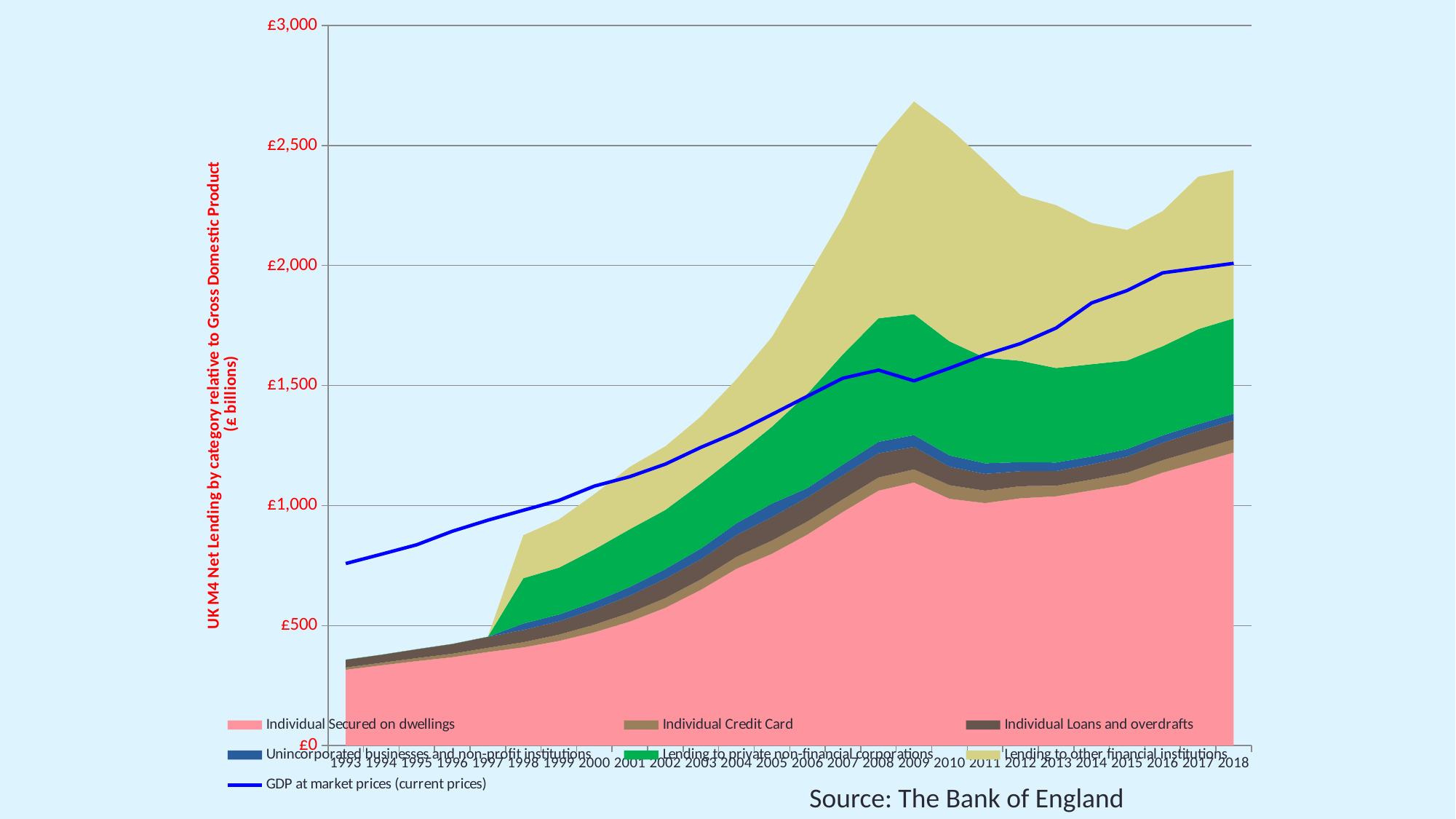
How many series does the legend list? 7 What source is cited for the chart? The Bank of England Is the value for Individual Secured on dwellings in 2018 greater or less than £1,000? greater Is the total stacked lending in 2018 greater or less than £2,500? less Does the GDP at market prices line generally rise or fall from 1993 to 2018? Rise Is the value of GDP at market prices in 1993 greater or less than £1,000? less How many years are shown along the x axis? 26 What kind of chart is shown on the slide? Stacked area chart with a line series Which is larger: the total stacked lending in 2009 or in 2018? 2009 In which year does the total stacked lending reach its highest point? 2009